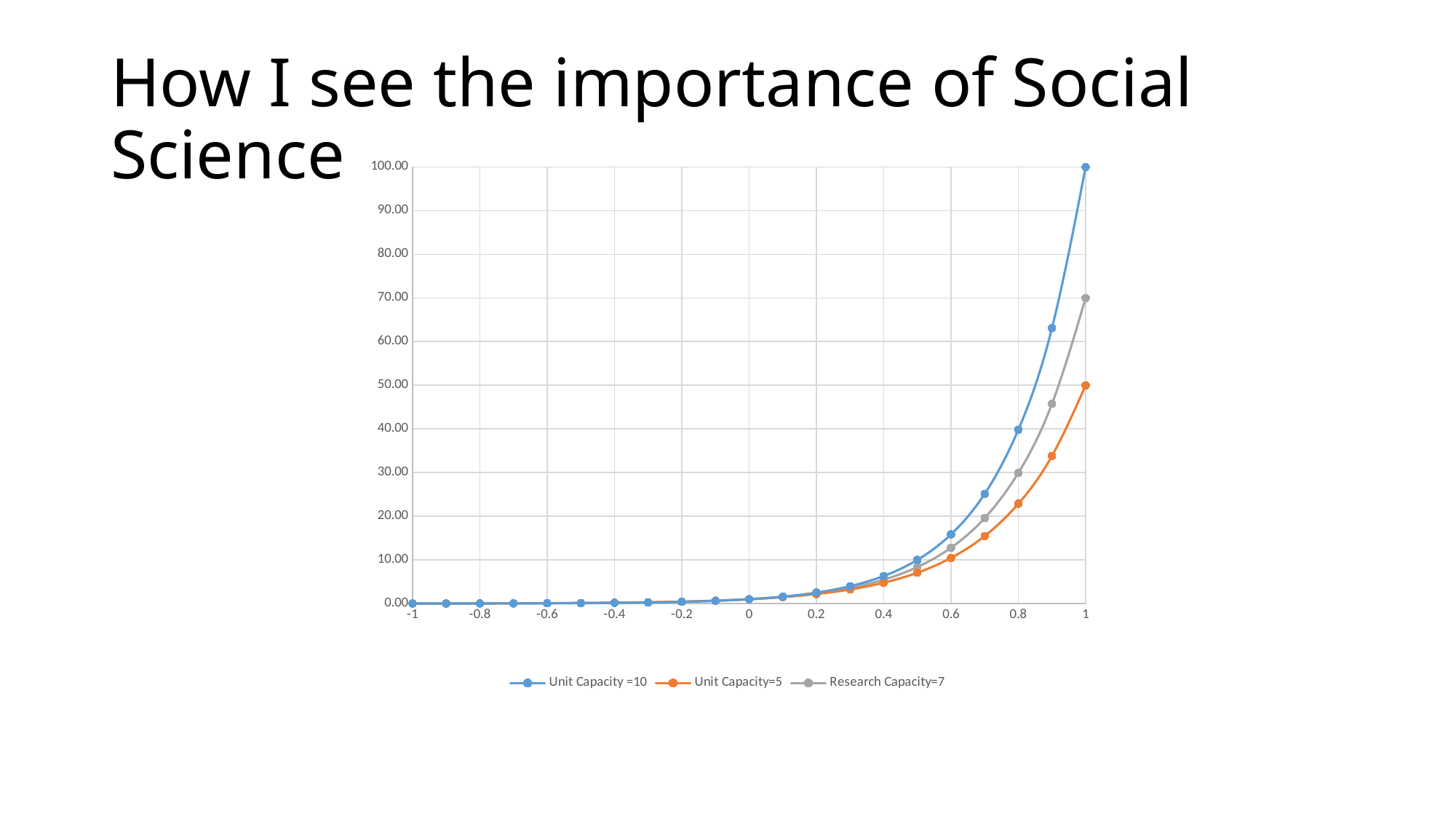
Do the values of the series rise or fall as x increases from -1 to 1? Rise At x = 0.8, which is larger: Research Capacity=7 or Unit Capacity=5? Research Capacity=7 What kind of chart is shown on the slide? Line chart What is the value of Unit Capacity=5 at x = 1? 50.00 Which series has the lowest value at x = 1? Unit Capacity=5 Which series has the highest value at x = 1? Unit Capacity =10 What is the value of Unit Capacity =10 at x = 1? 100.00 What is the difference between Unit Capacity =10 and Unit Capacity=5 at x = 1? 50.00 What is the value of Research Capacity=7 at x = 1? 70.00 Is the value for Unit Capacity =10 at x = 0.8 greater or less than 30.00? greater Is the value for Unit Capacity=5 at x = 0.9 greater or less than 40.00? less How many series does the legend list? 3